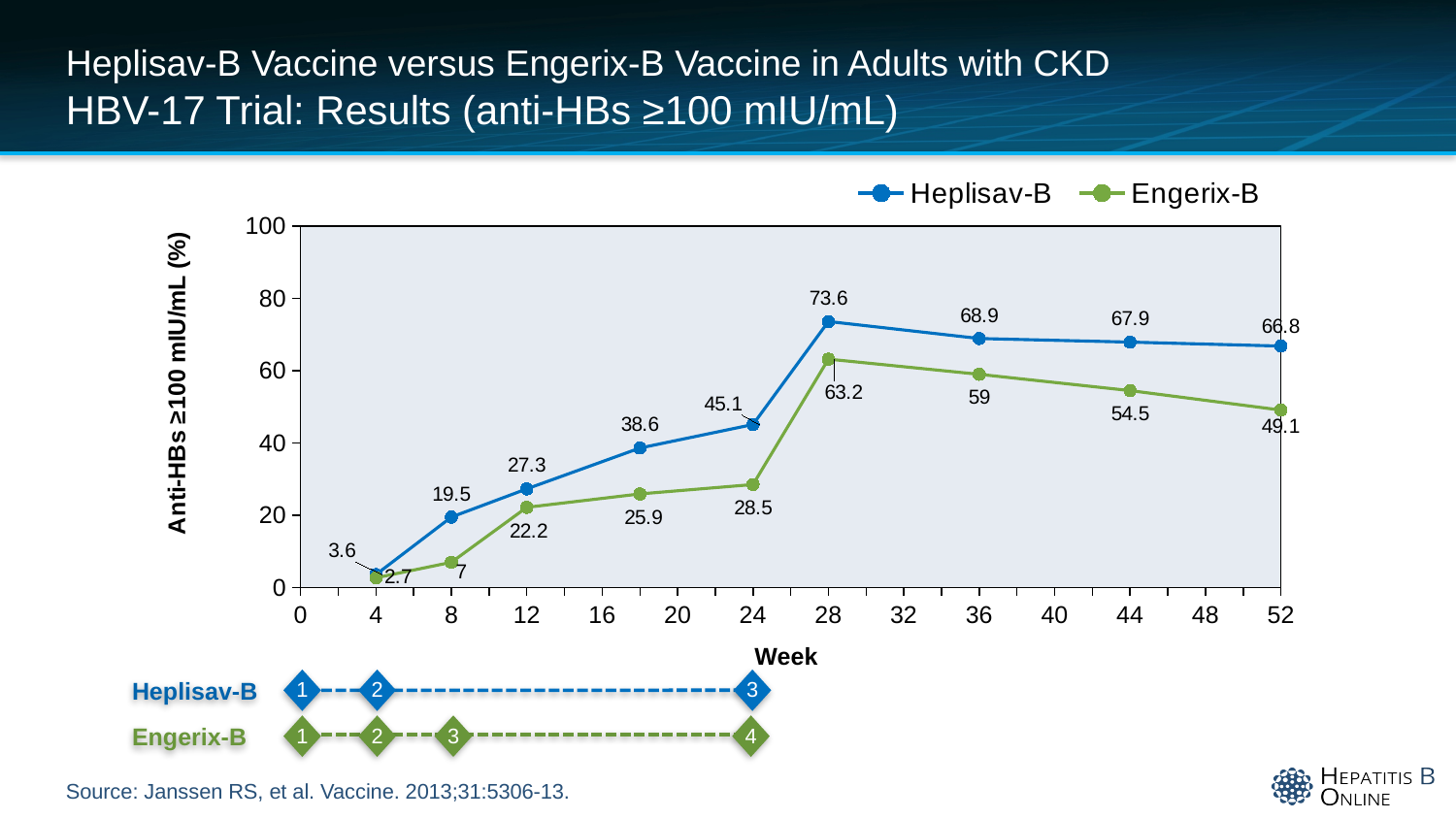
Does the Heplisav-B series rise or fall between week 28 and week 52? Fall What is the Heplisav-B value at week 8? 19.5 What is the label of the y axis? Anti-HBs ≥100 mIU/mL (%) At which week is the Engerix-B value lowest? Week 4 What is the difference between the Heplisav-B and Engerix-B values at week 28? 10.4 How many series does the legend list? 2 What type of chart is shown on the slide? Line chart What is the Engerix-B value at week 52? 49.1 At which week does the Heplisav-B series reach its highest value? Week 28 What is the Heplisav-B value at week 28? 73.6 How many data points are plotted for the Heplisav-B series? 9 Which series has the higher value at week 24, Heplisav-B or Engerix-B? Heplisav-B